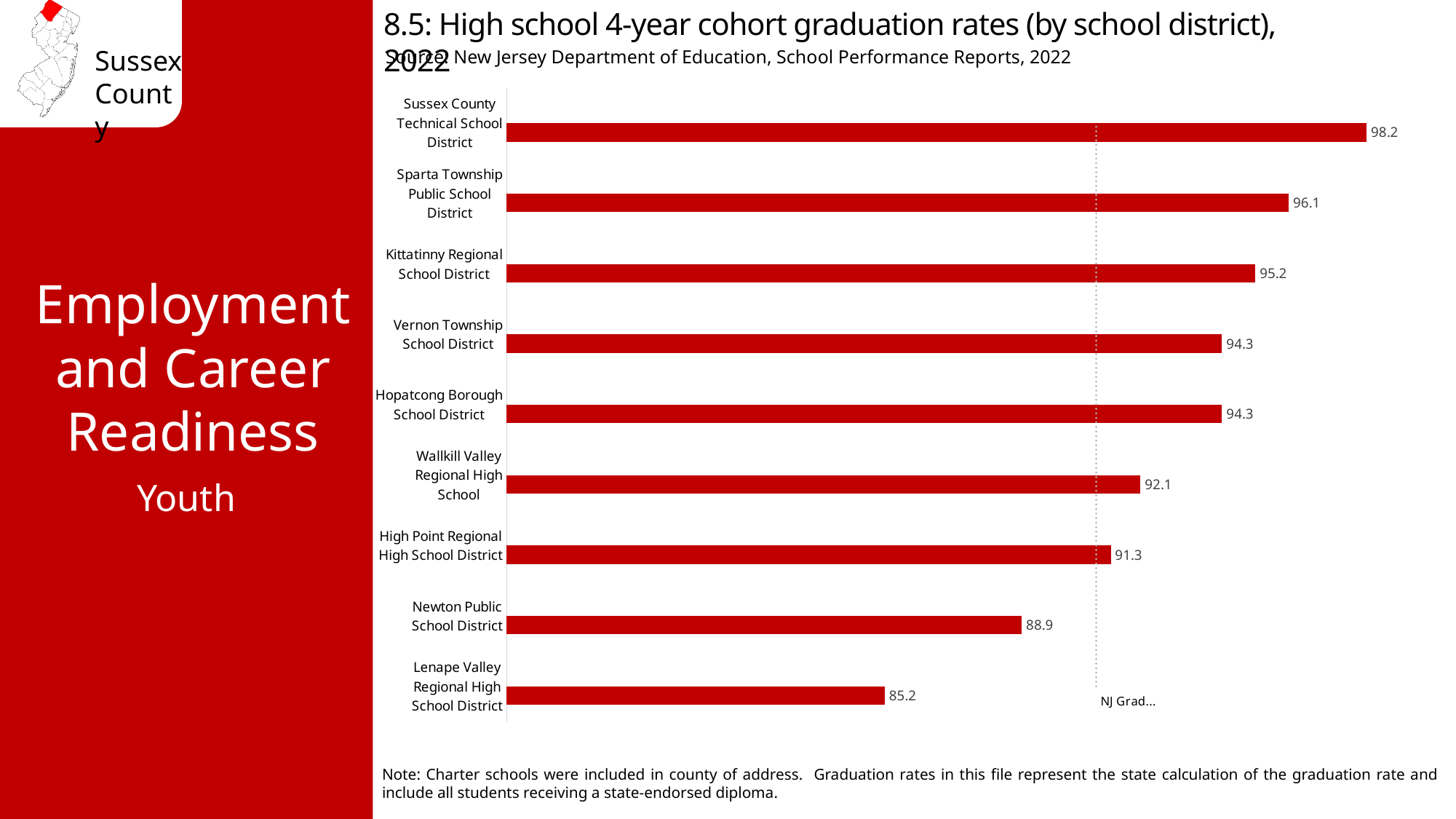
What is the graduation rate shown for Newton Public School District? 88.9 Which two school districts share the same graduation rate of 94.3? Vernon Township School District and Hopatcong Borough School District What is the 4-year cohort graduation rate for Sussex County Technical School District? 98.2 Which has a higher graduation rate, High Point Regional High School District or Newton Public School District? High Point Regional High School District What is the source cited for the chart data? New Jersey Department of Education, School Performance Reports, 2022 How many school districts are shown on the chart? 9 What is the graduation rate shown for Wallkill Valley Regional High School? 92.1 What is the difference between the graduation rates of Sparta Township Public School District and Kittatinny Regional School District? 0.9 What type of chart is used on this slide? Bar chart What is the difference between the graduation rates of Sussex County Technical School District and Lenape Valley Regional High School District? 13 Which school district has the highest graduation rate on the chart? Sussex County Technical School District Which school district has the lowest graduation rate on the chart? Lenape Valley Regional High School District